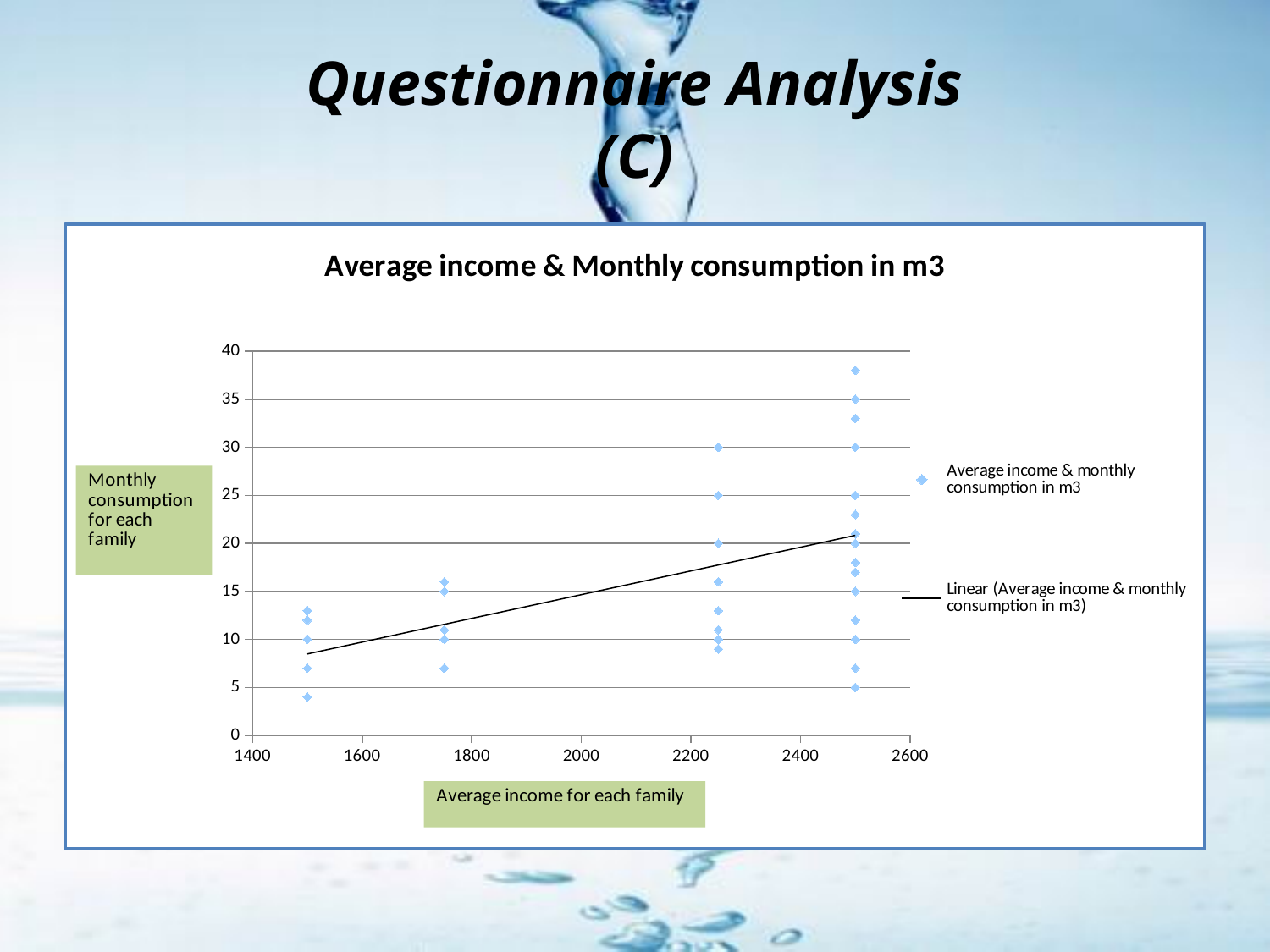
Is the highest monthly consumption point at an income of 2250 greater or less than 25? greater What is the label on the horizontal axis of the chart? Average income for each family Does the linear trendline rise or fall as average income increases along the x axis? rise What is the title of the chart? Average income & Monthly consumption in m3 How many distinct average income values have data points plotted? 4 How many entries does the chart legend list? 2 Is the highest monthly consumption point at an income of 2500 greater or less than 35? greater At which average income value does the highest monthly consumption point appear? 2500 What kind of chart is shown on the slide? scatter chart Is the lowest monthly consumption point at an income of 1500 greater or less than 10? less